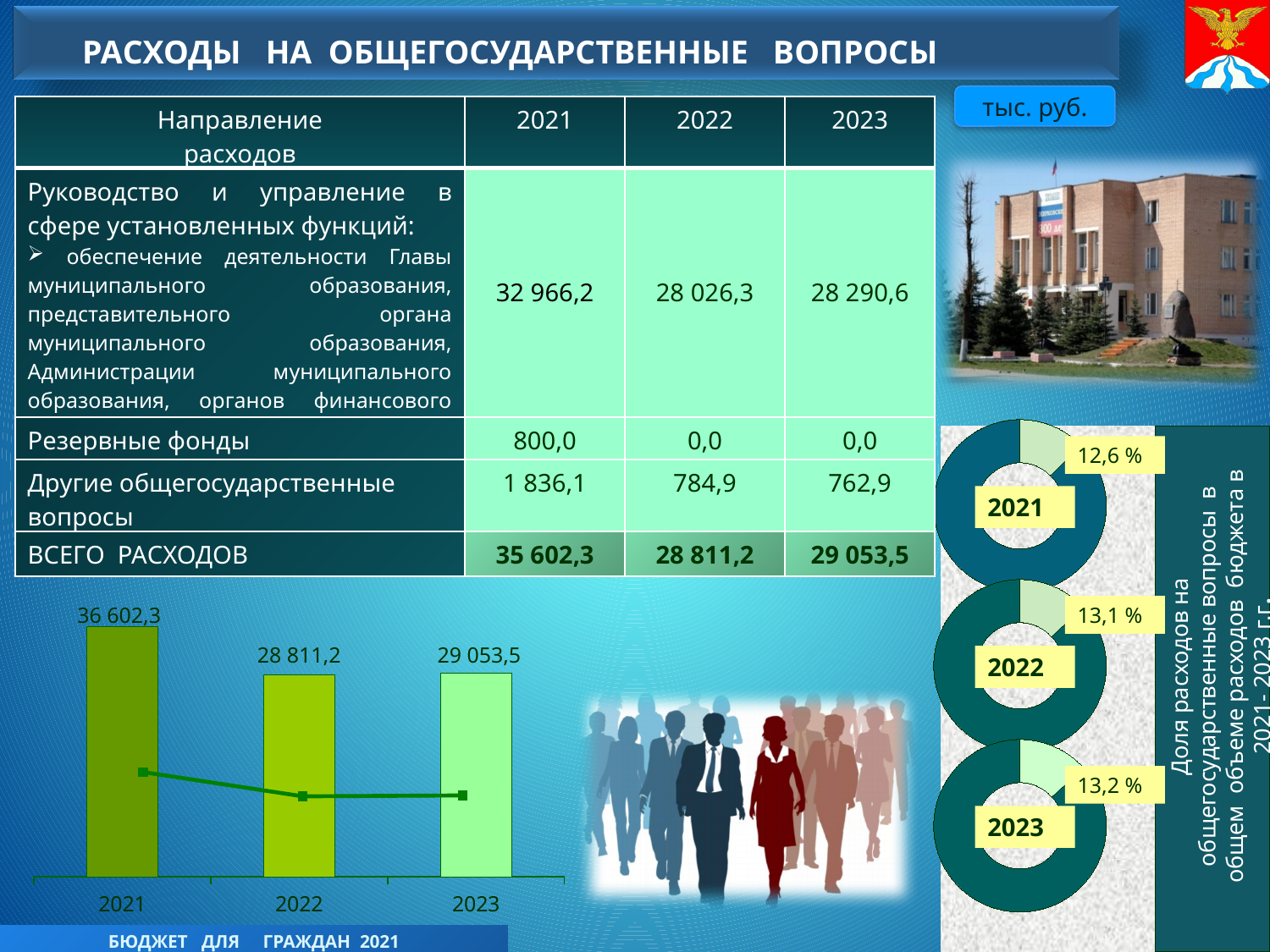
In the bar chart at the bottom left, what is the value shown for 2023? 29 053,5 In the bar chart at the bottom left, what is the value shown for 2021? 36 602,3 In the donut charts on the right, what share is shown for 2023? 13,2 % What kind of chart is shown at the bottom left of the slide? bar chart In the donut charts on the right, which year has the highest share? 2023 How many bars are in the bar chart at the bottom left? 3 In the bar chart at the bottom left, which year has the highest value? 2021 In the bar chart at the bottom left, is the value for 2023 larger or smaller than the value for 2022? larger In the donut charts on the right, what share is shown for 2021? 12,6 % In the bar chart at the bottom left, which year has the lowest value? 2022 In the bar chart at the bottom left, what is the value shown for 2022? 28 811,2 In the bar chart at the bottom left, what is the difference between the 2021 value and the 2022 value? 7 791,1